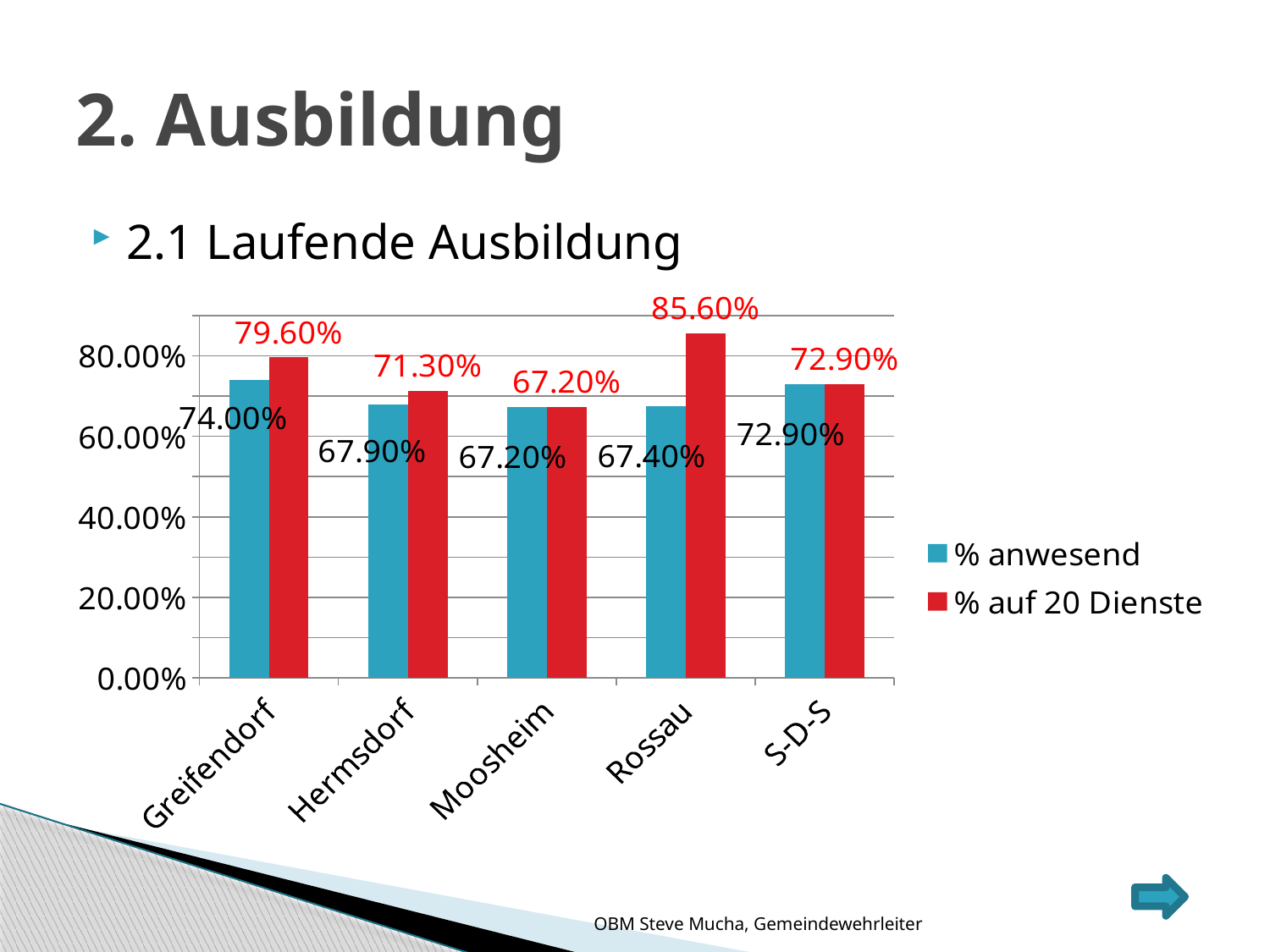
Which category has the lowest value for "% auf 20 Dienste"? Moosheim For Greifendorf, which is larger: "% anwesend" or "% auf 20 Dienste"? % auf 20 Dienste Is the value of "% auf 20 Dienste" for Rossau greater or less than 80.00%? greater What is the value of "% auf 20 Dienste" for Hermsdorf? 71.30% What kind of chart is shown on the slide? bar chart What is the value of "% auf 20 Dienste" for Rossau? 85.60% How many series does the chart's legend list? 2 What is the value of "% anwesend" for S-D-S? 72.90% What is the difference between "% auf 20 Dienste" and "% anwesend" for Rossau? 18.20% How many categories are shown on the x axis of the chart? 5 What is the value of "% anwesend" for Greifendorf? 74.00% Which category has the highest value for "% auf 20 Dienste"? Rossau